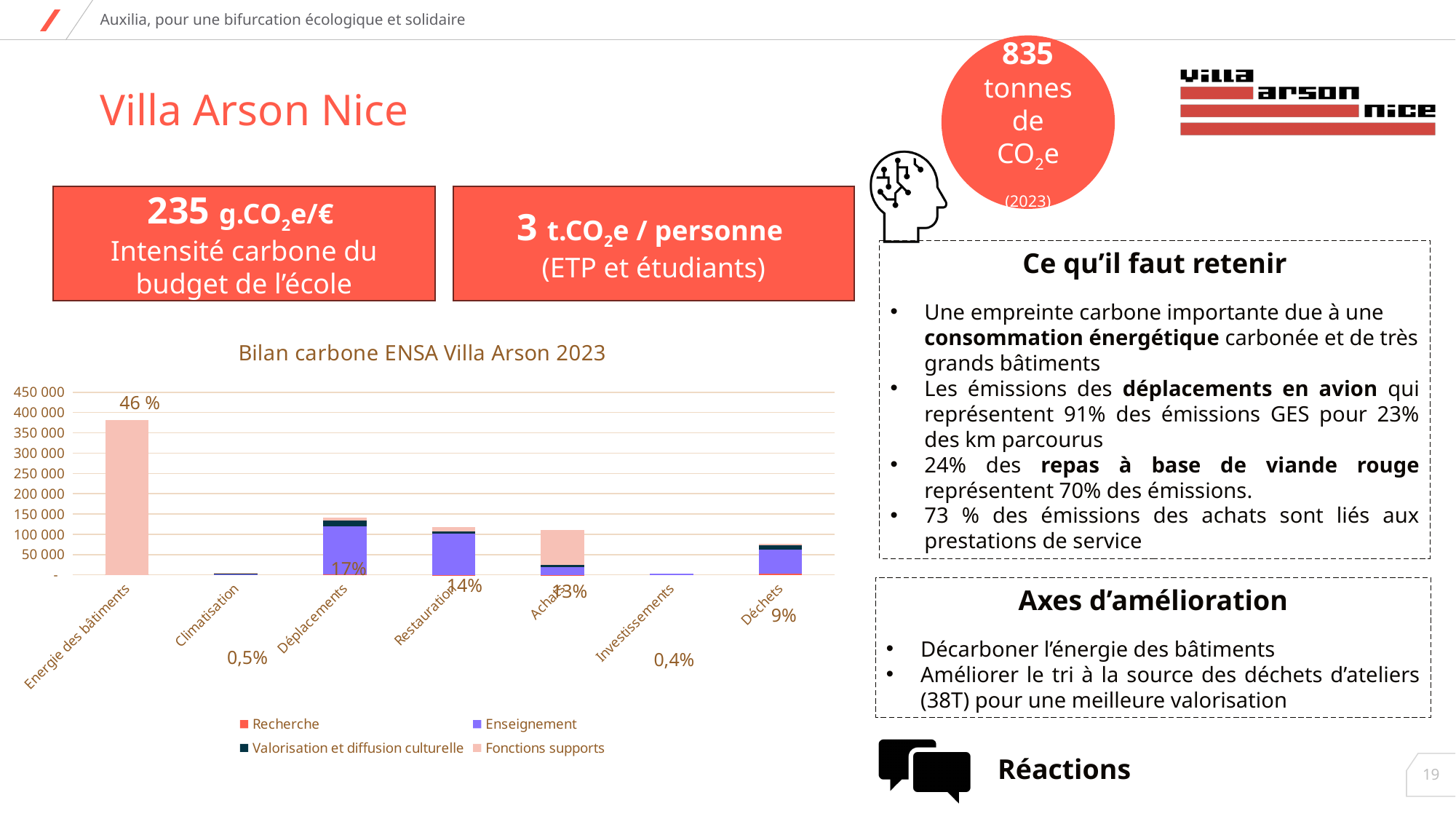
What type of chart is shown on the slide? Stacked bar chart Is the total value for Energie des bâtiments greater or less than 350 000? greater What percentage label is shown for Energie des bâtiments? 46 % Is the total value for Déchets greater or less than 100 000? less What percentage label is shown for Déchets? 9% Which is larger, the total bar for Déplacements or the total bar for Déchets? Déplacements What percentage label is shown for Investissements? 0,4% What percentage label is shown for Déplacements? 17% What is the title of the chart? Bilan carbone ENSA Villa Arson 2023 How many categories are shown on the x axis of the chart? 7 Which category has the highest total emissions in the chart? Energie des bâtiments How many series does the chart legend list? 4